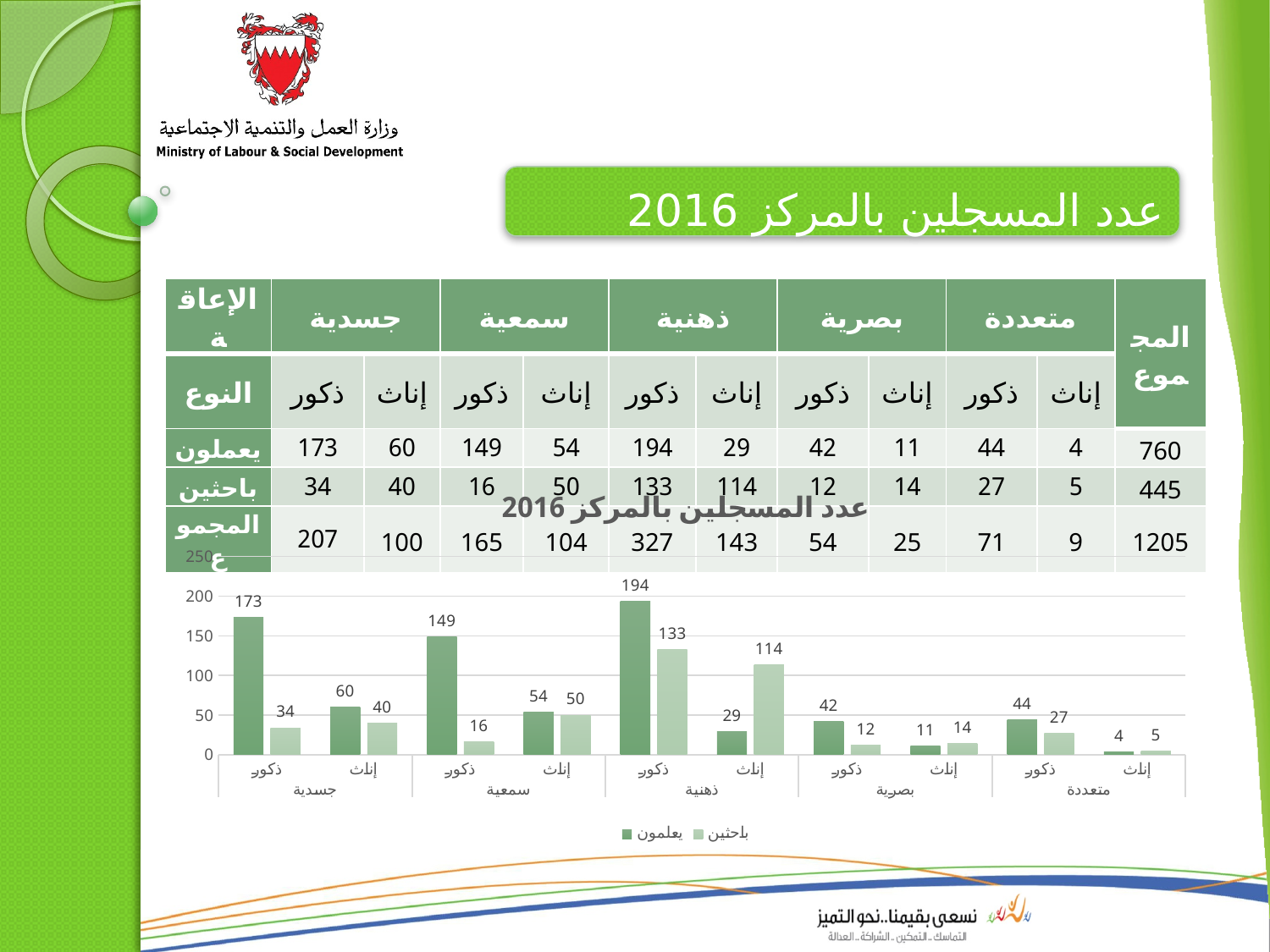
How many series does the chart legend list? 2 Which is larger for إناث in the سمعية group: يعملون or باحثين? يعملون What is the value of يعملون for ذكور in the سمعية group? 149 What is the value of يعملون for ذكور in the جسدية group? 173 What is the difference between يعملون and باحثين for ذكور in the ذهنية group? 61 What is the title of the chart? عدد المسجلين بالمركز 2016 How many disability groups are shown along the x axis of the chart? 5 What type of chart is shown on the slide? bar chart Which bar in the chart has the highest value? يعملون, ذكور, ذهنية (194) What is the value of باحثين for ذكور in the بصرية group? 12 Which bar in the chart has the lowest value? يعملون, إناث, متعددة (4) What is the value of باحثين for إناث in the ذهنية group? 114